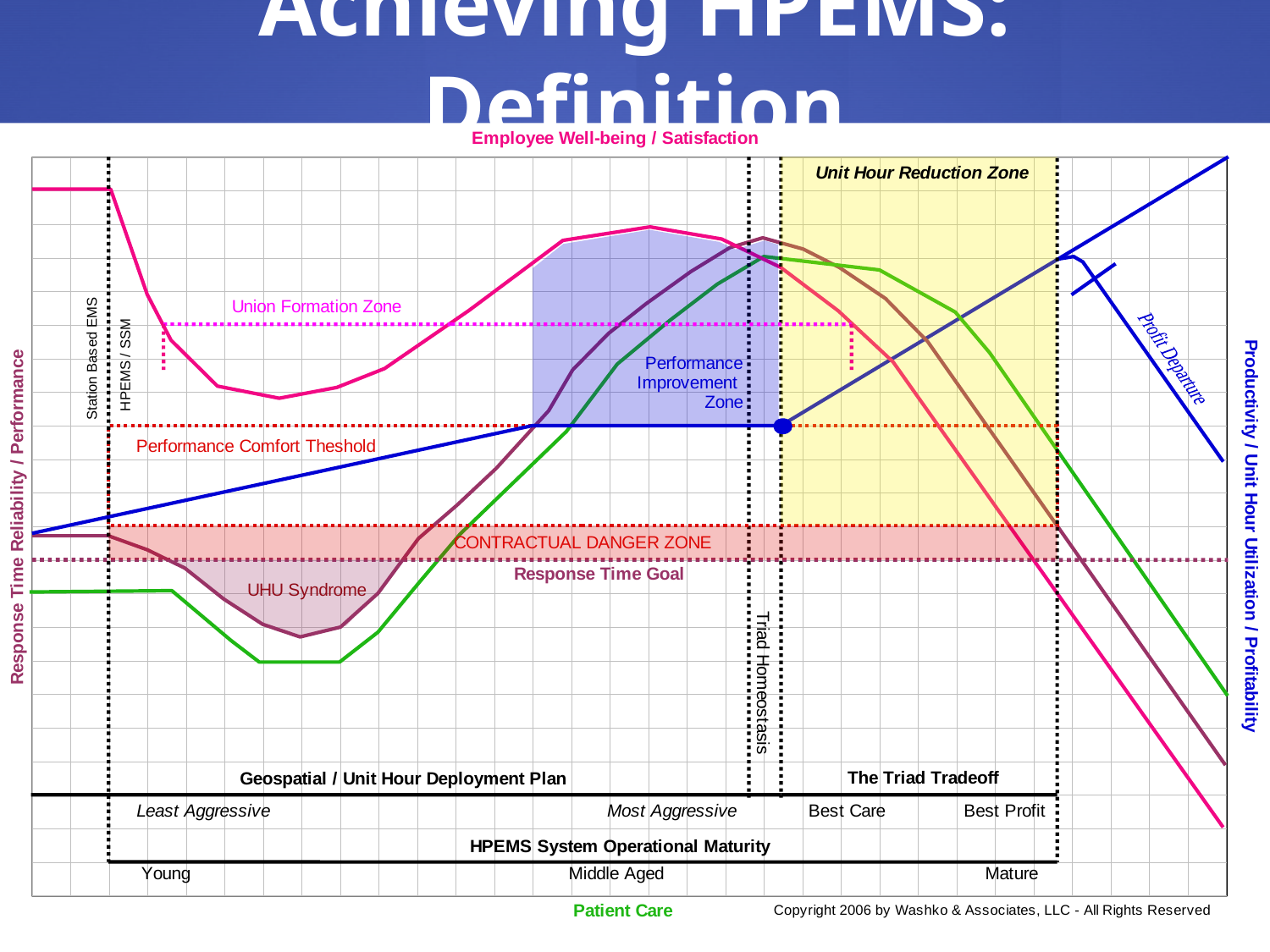
Does the pink line rise or fall between the Station Based EMS line and the UHU Syndrome area? fall At the Young stage on the far left, which line is higher, the pink line or the green line? the pink line Does the green line rise or fall within the Performance Improvement Zone? rise Does the blue line rise or fall from the Young stage to the Mature stage? rise What is the label on the left vertical axis of the chart? Response Time Reliability / Performance At the right edge of the Unit Hour Reduction Zone, which line is higher, the blue line or the pink line? the blue line What kind of chart is shown on the slide? line chart What is the name of the zone shaded yellow on the chart? Unit Hour Reduction Zone How many maturity stages are labeled along the HPEMS System Operational Maturity axis? 3